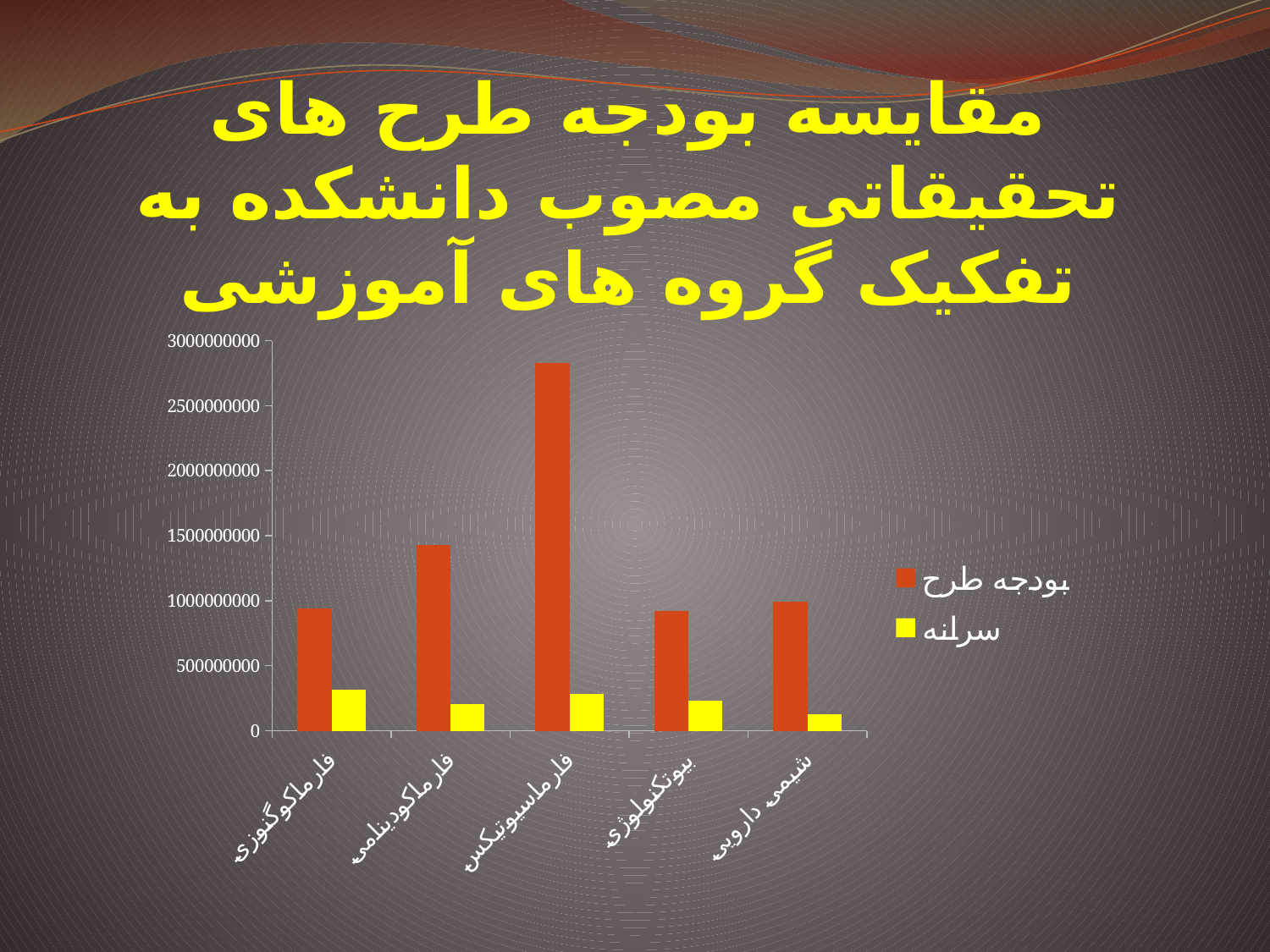
Is the value of سرانه for فارماکوگنوزی greater or less than 500000000? less Which series is shown in orange bars? بودجه طرح Which colour represents the سرانه series in the legend? yellow What kind of chart is shown on the slide? bar chart Is the value of بودجه طرح for فارماسیوتیکس greater or less than 2500000000? greater How many series does the legend list? 2 Which category has the highest value for بودجه طرح? فارماسیوتیکس Is the value of بودجه طرح for بیوتکنولوژی greater or less than 1000000000? less How many categories (educational groups) are shown on the x axis? 5 Which category has the lowest value for سرانه? شیمی دارویی Which is larger, the بودجه طرح value for فارماکودینامی or for فارماکوگنوزی? فارماکودینامی